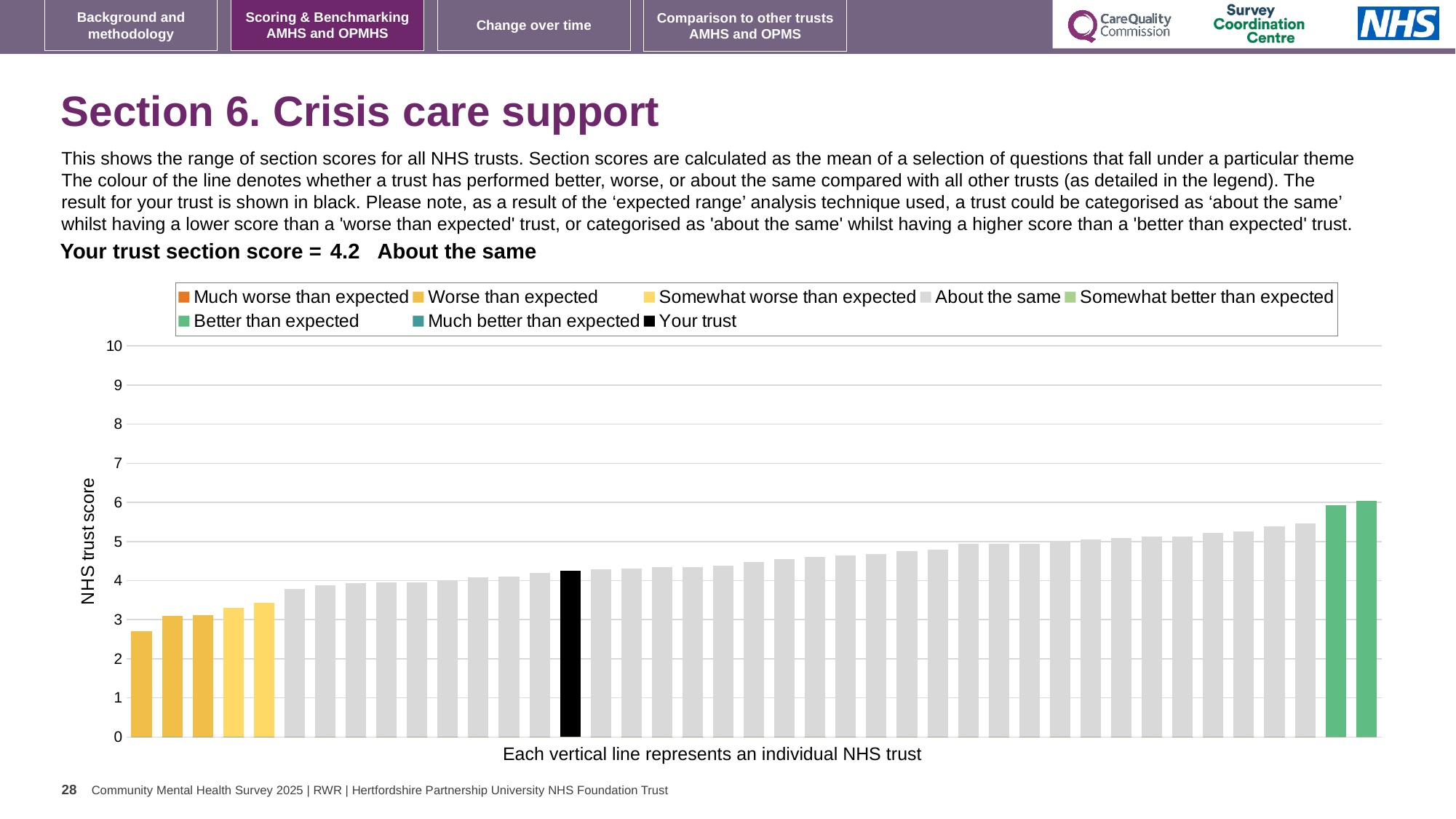
What is the title of the vertical axis? NHS trust score What is the section score for your trust? 4.2 Which legend category does your trust fall into? About the same How many bars are coloured as 'Better than expected' (green)? 2 What kind of chart is shown on the slide? Bar chart Do the bar values rise or fall from left to right along the x axis? Rise Is the value of the rightmost (highest) bar greater or less than 5? greater Is the value of the leftmost (lowest) bar greater or less than 3? less How many entries does the chart legend list? 8 Is the value for your trust (the black bar) greater or less than 4? greater Which is larger: the value of your trust's black bar or the value of the leftmost bar? Your trust's black bar